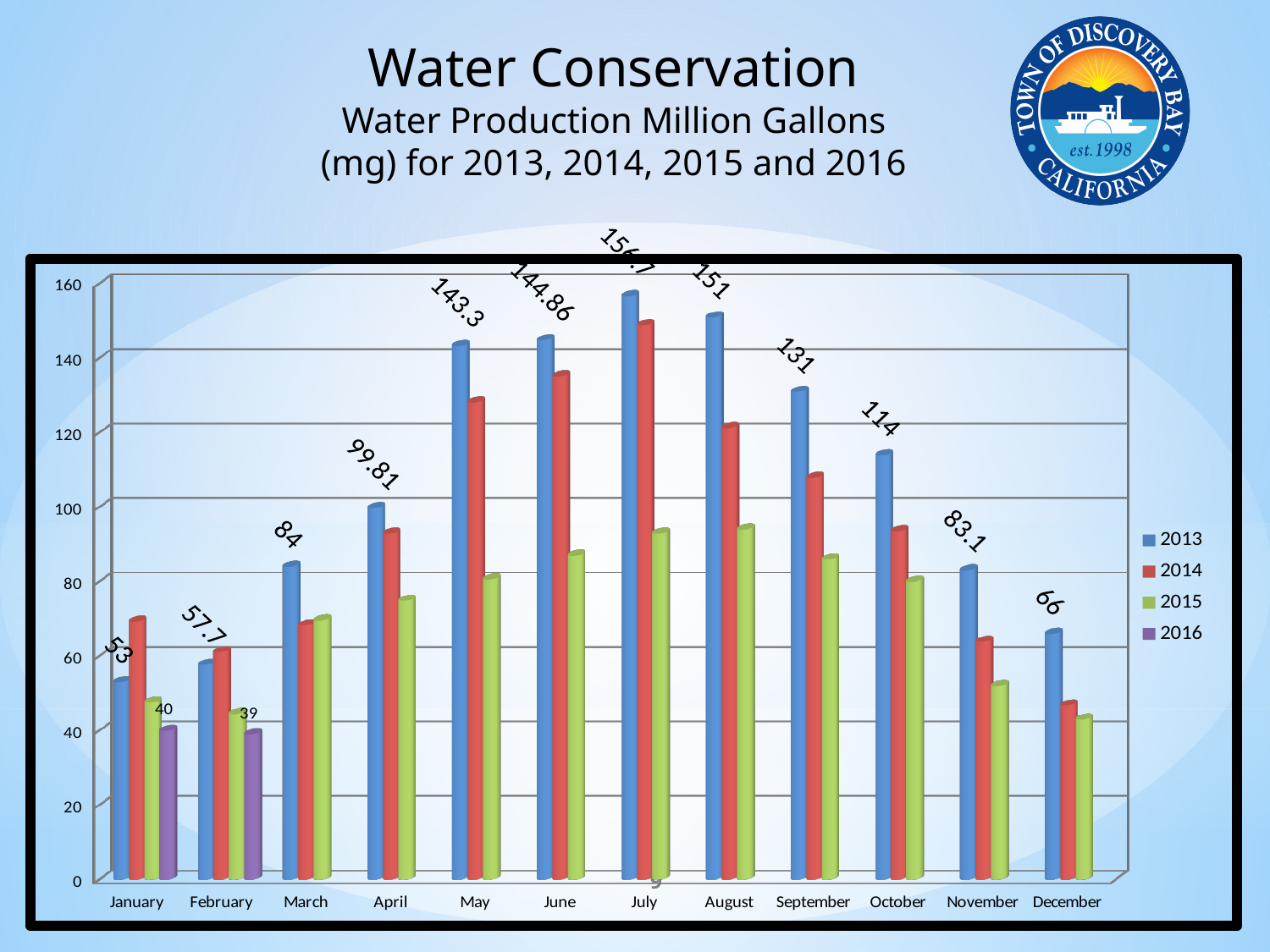
Which series is shown in purple in the legend? 2016 Which month has the highest 2013 value? July What is the difference between the 2013 values for July and August? 5.7 Is the 2014 value for July greater or less than 140? greater How many series does the legend list? 4 What type of chart is shown on the slide? bar chart Which month has the lowest 2013 value? January What is the 2016 value for January? 40 What is the 2013 value for April? 99.81 How many months are shown on the x axis? 12 Which is larger, the 2013 value for May or the 2013 value for June? June What is the 2013 value for July? 156.7